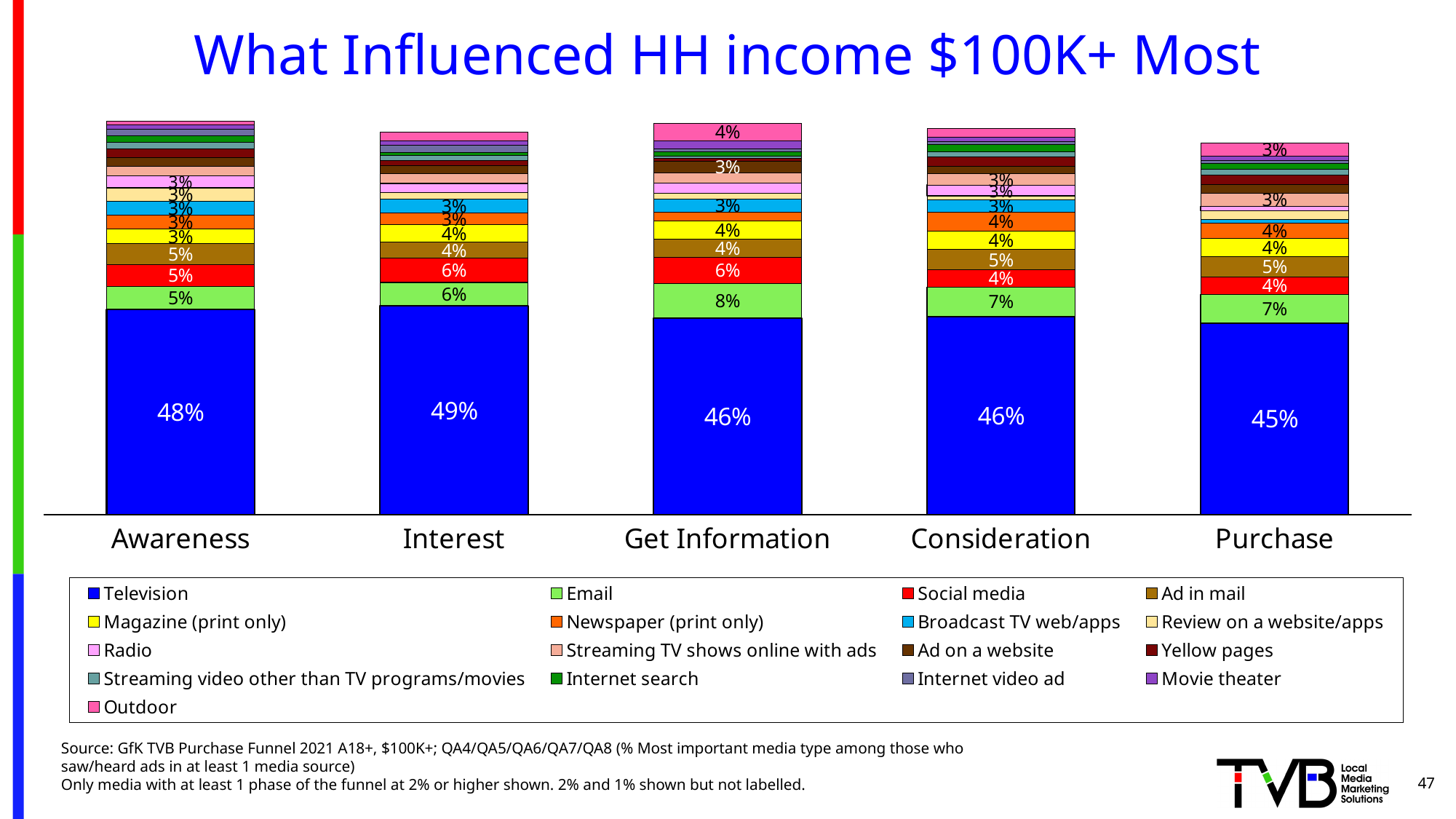
What percentage does Television account for in the Awareness stage? 48% What is the Email value for the Get Information stage? 8% How many media types does the legend list? 17 What is the Social media value for the Interest stage? 6% What is the Television value for the Interest stage? 49% In which funnel stage is the Television share lowest? Purchase What is the difference between the Television value for Interest and the Television value for Purchase? 4 percentage points What is the Outdoor value for the Get Information stage? 4% Which stage has the larger Email value, Awareness or Get Information? Get Information In which funnel stage is the Television share highest? Interest How many funnel stages are shown on the x axis? 5 What kind of chart is shown on the slide? Stacked bar chart